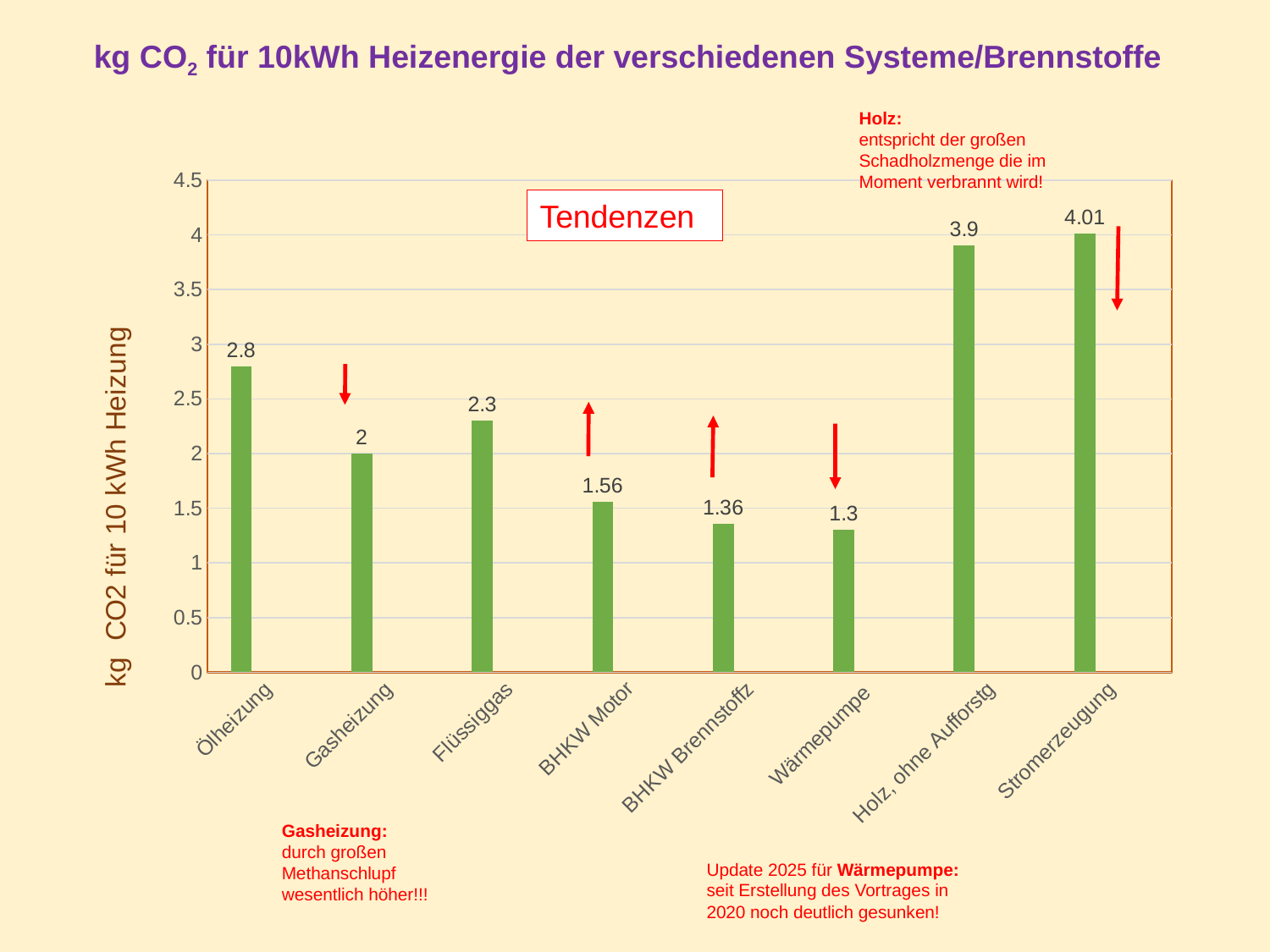
How many categories are shown on the x axis? 8 What is the value for BHKW Motor? 1.56 What is the label of the y axis? kg CO2 für 10 kWh Heizung What is the difference between the values for Stromerzeugung and Holz, ohne Aufforstg? 0.11 Which category has the highest value? Stromerzeugung What is the value for Ölheizung? 2.8 What is the difference between the values for Ölheizung and Gasheizung? 0.8 What is the value for Holz, ohne Aufforstg? 3.9 Which is larger, the value for Flüssiggas or the value for BHKW Brennstoffz? Flüssiggas What is the value for Wärmepumpe? 1.3 Which category has the lowest value? Wärmepumpe What kind of chart is shown on the slide? bar chart